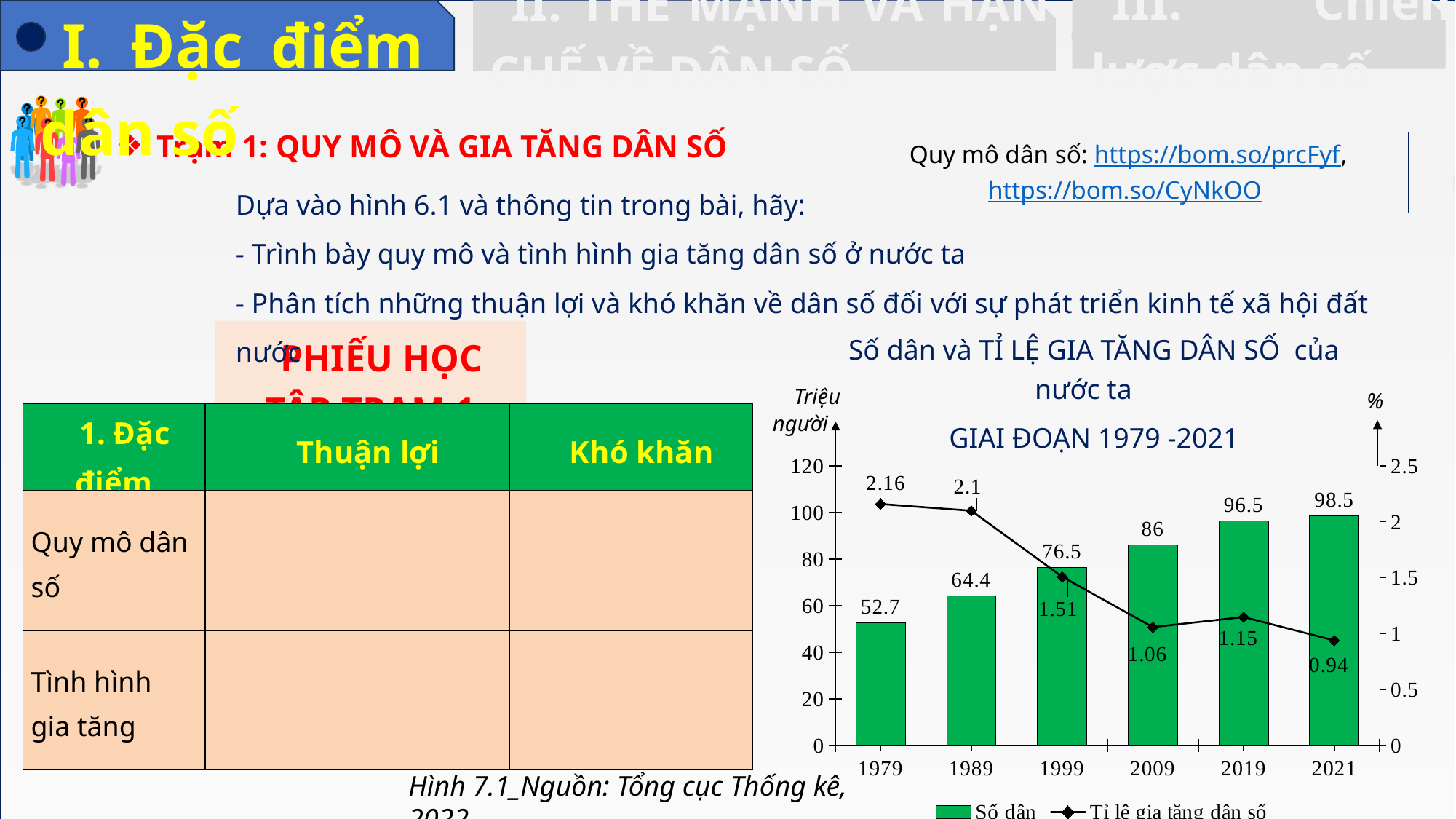
How many series does the chart legend list? 2 Which year has the highest population (Số dân)? 2021 Does the population (Số dân) rise or fall from 1979 to 2021? rise What kind of chart is used to show Số dân? bar chart What is the population (Số dân) shown for 1979? 52.7 What unit is shown on the left vertical axis of the chart? Triệu người What is the difference in population (Số dân) between 2021 and 1979? 45.8 Which is larger, the growth rate (Tỉ lệ gia tăng dân số) in 2009 or in 2019? 2019 What is the population growth rate (Tỉ lệ gia tăng dân số) shown for 2021? 0.94 How many years are shown on the x axis of the chart? 6 Which year has the lowest population growth rate (Tỉ lệ gia tăng dân số)? 2021 What is the population (Số dân) shown for 2009? 86